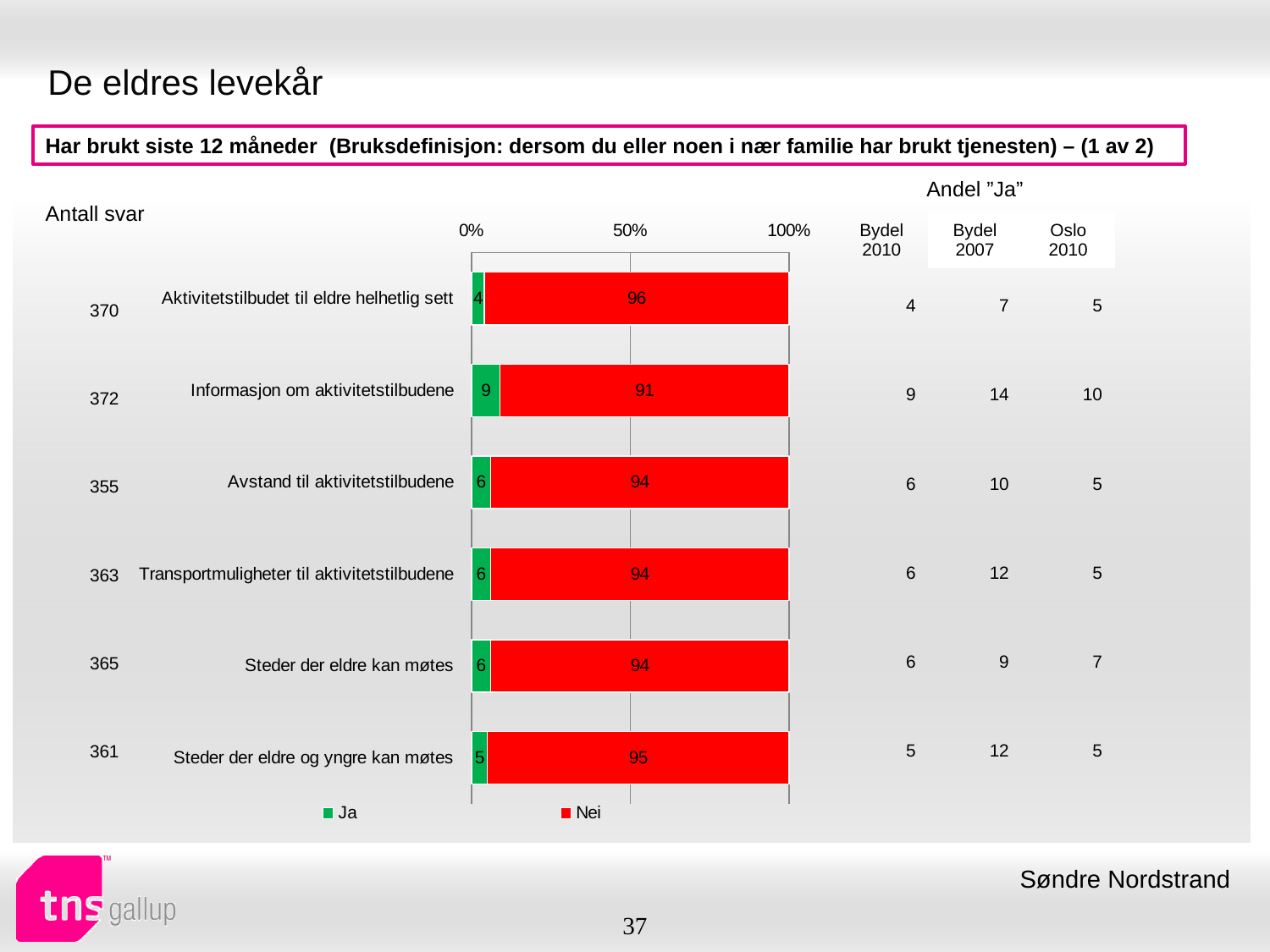
Which is larger: the 'Ja' value for 'Informasjon om aktivitetstilbudene' or the 'Ja' value for 'Steder der eldre og yngre kan møtes'? Informasjon om aktivitetstilbudene What is the 'Ja' value for 'Informasjon om aktivitetstilbudene'? 9 How many categories are plotted in the chart? 6 How many series does the chart legend list? 2 Which category has the highest 'Ja' value? Informasjon om aktivitetstilbudene What kind of chart is shown on the slide? Stacked bar chart What is the 'Nei' value for 'Aktivitetstilbudet til eldre helhetlig sett'? 96 Which category has the lowest 'Ja' value? Aktivitetstilbudet til eldre helhetlig sett What is the total of the stacked bar for 'Avstand til aktivitetstilbudene'? 100 What is the 'Nei' value for 'Steder der eldre og yngre kan møtes'? 95 What are the two legend entries in the chart? Ja and Nei What is the difference between the 'Nei' values for 'Aktivitetstilbudet til eldre helhetlig sett' and 'Informasjon om aktivitetstilbudene'? 5